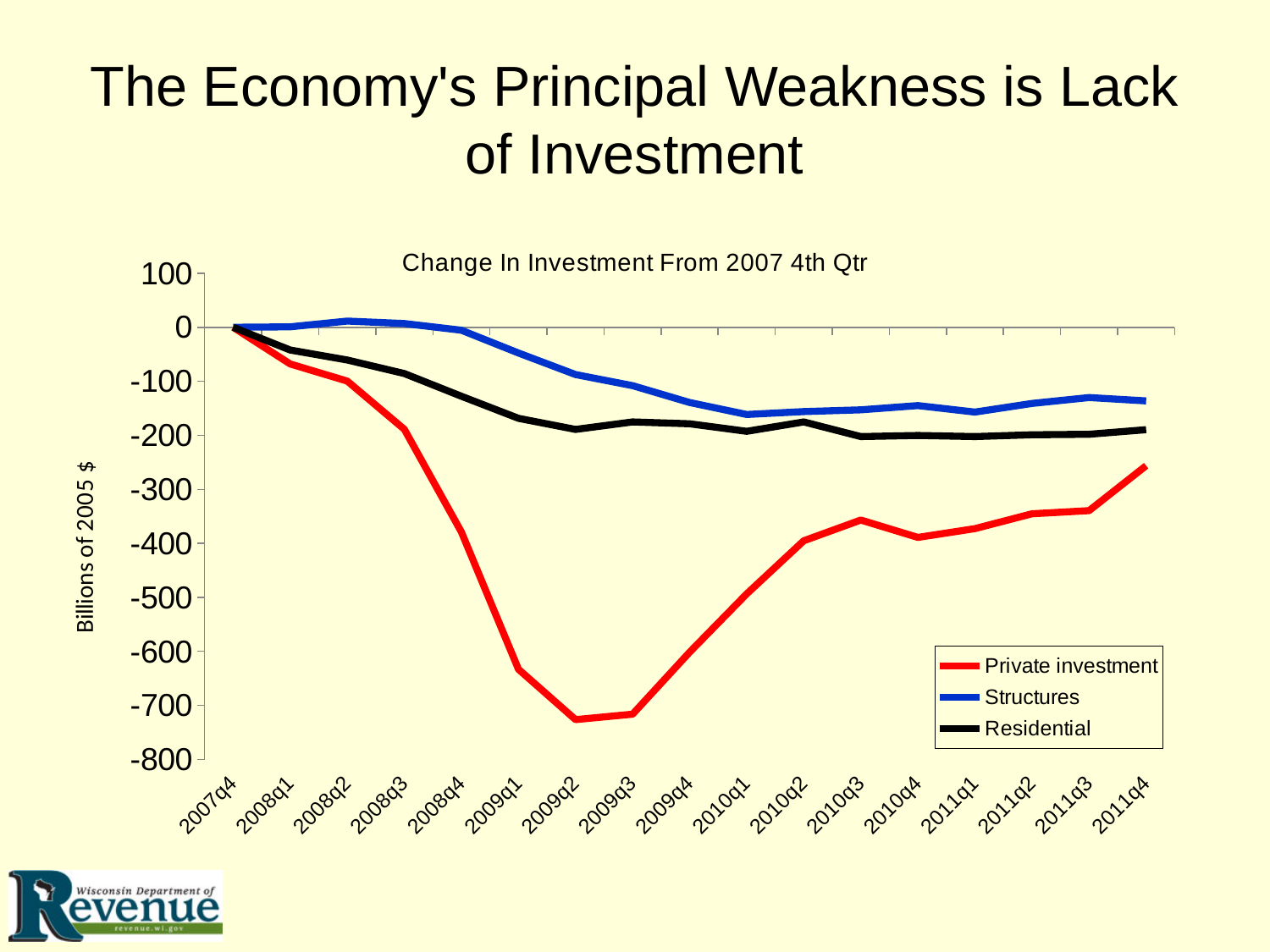
Which series reaches the lowest value on the chart? Private investment Is the value for Residential in 2011q4 greater or less than -100? less Does the Private investment line rise or fall from 2009q2 to 2011q4? rise Is the value for Private investment in 2009q2 greater or less than -700? less What is the title of the chart? Change In Investment From 2007 4th Qtr How many quarters are plotted along the x axis? 17 In 2009q2, which series has the higher value, Structures or Private investment? Structures What kind of chart is shown on the slide? line chart What is the label on the vertical axis? Billions of 2005 $ How many series does the legend list? 3 Is the value for Private investment in 2011q4 greater or less than -300? greater